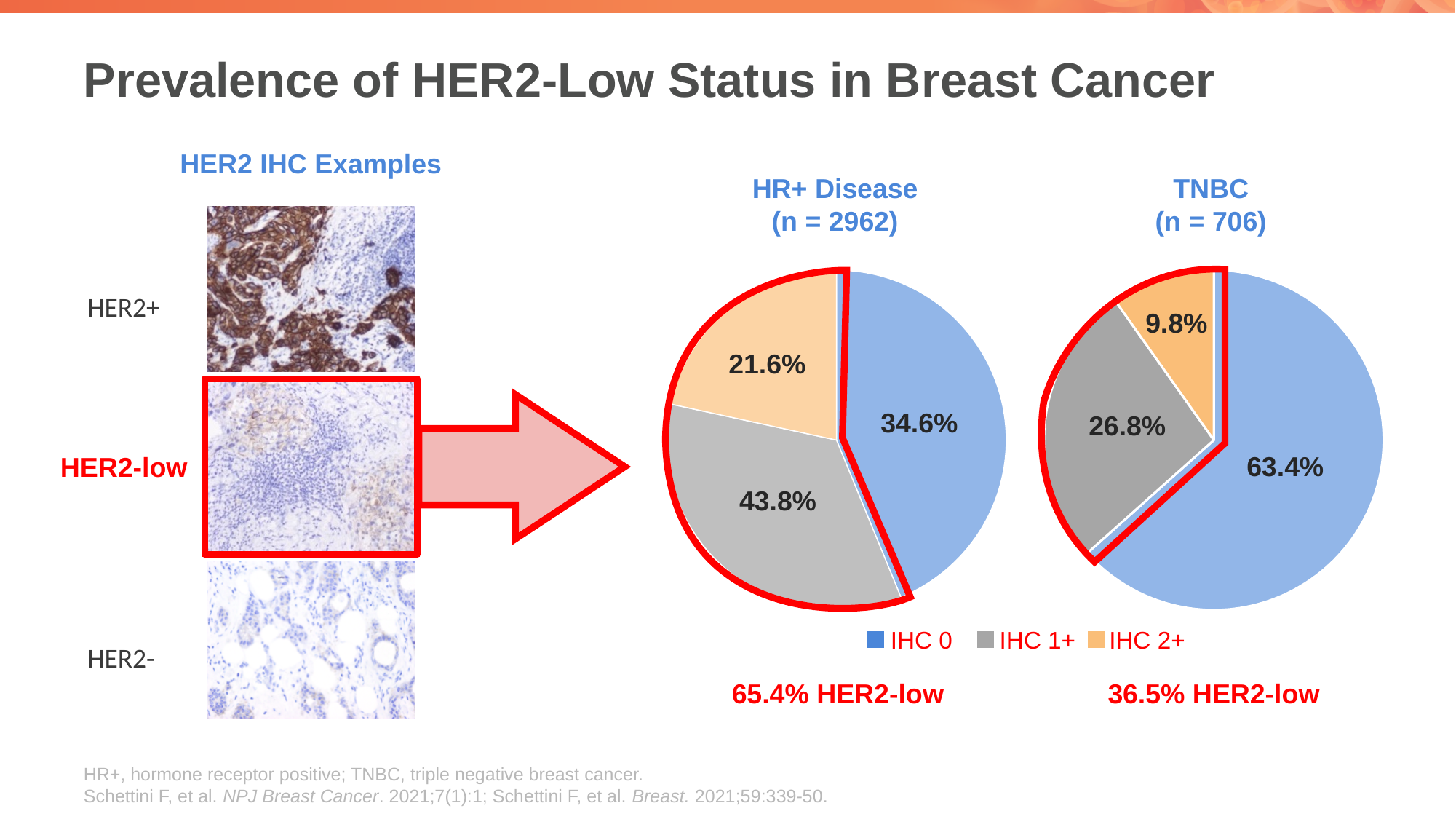
What type of chart is used to show the HR+ Disease and TNBC data? Pie chart How many series does the legend list for the pie charts? 3 What is the sample size (n) shown for the TNBC pie chart? 706 In the HR+ Disease pie chart, what percentage is IHC 2+? 21.6% Which chart has the larger IHC 0 share, HR+ Disease or TNBC? TNBC In the TNBC pie chart, what is the difference between the IHC 0 and IHC 1+ percentages? 36.6% In the HR+ Disease pie chart, which IHC category has the largest share? IHC 1+ In the TNBC pie chart, what percentage is IHC 0? 63.4% In the HR+ Disease pie chart, what percentage is IHC 1+? 43.8% In the HR+ Disease pie chart, what is the difference between the IHC 1+ and IHC 0 percentages? 9.2% In the TNBC pie chart, what percentage is IHC 2+? 9.8% In the TNBC pie chart, which IHC category has the smallest share? IHC 2+